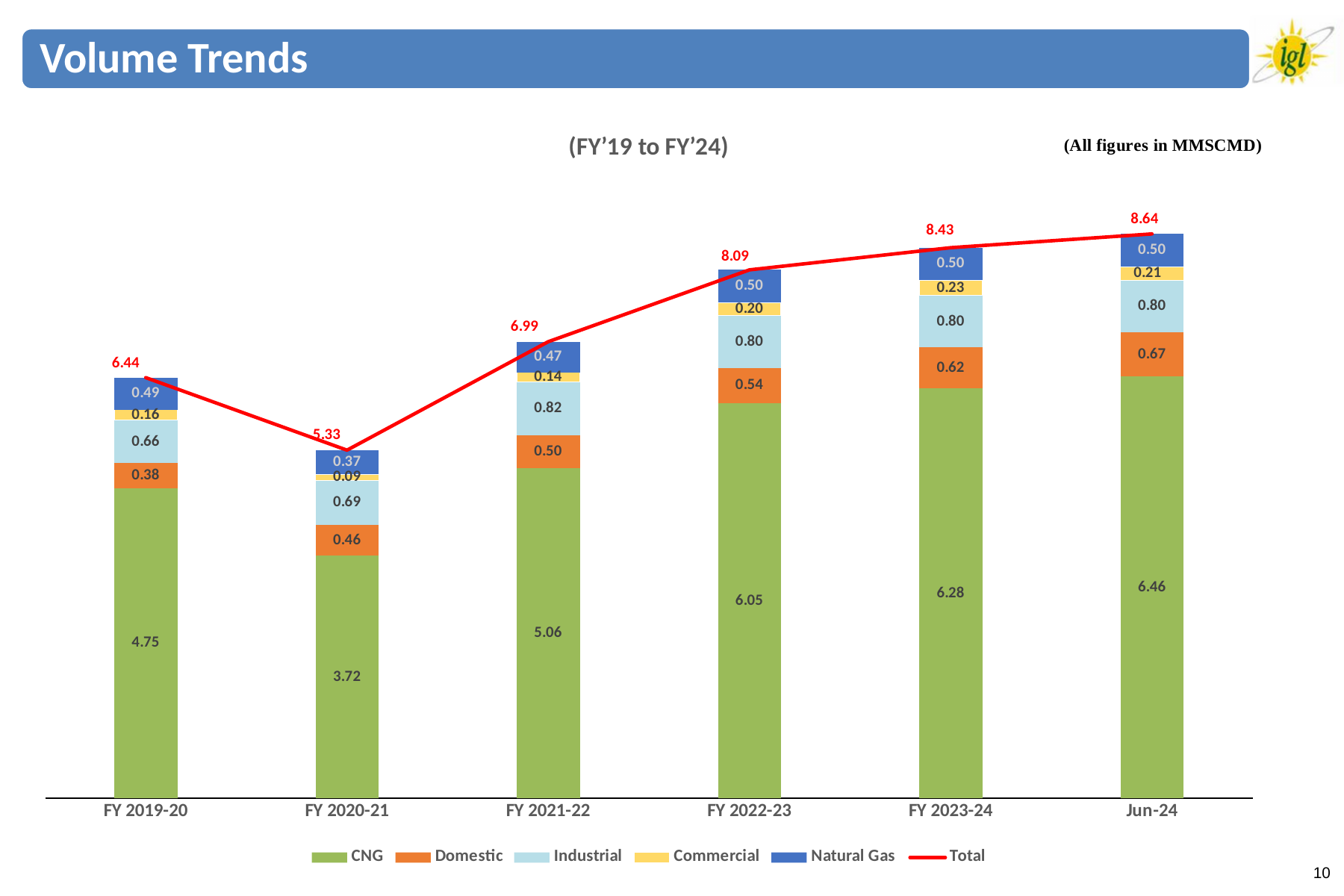
How many series does the legend list? 6 What is the difference between the Total for Jun-24 and the Total for FY 2019-20? 2.20 What is the Domestic value for Jun-24? 0.67 What is the CNG value for FY 2021-22? 5.06 What is the Total value for FY 2022-23? 8.09 Which period has the lowest Total value? FY 2020-21 How many periods are shown on the x axis? 6 Which period has the highest CNG value? Jun-24 What is the Commercial value for FY 2020-21? 0.09 What kind of chart is shown on the slide? Stacked bar chart with a line Which is larger, the Industrial value for FY 2021-22 or the Industrial value for FY 2020-21? FY 2021-22 What is the total of the stacked bar for FY 2023-24? 8.43